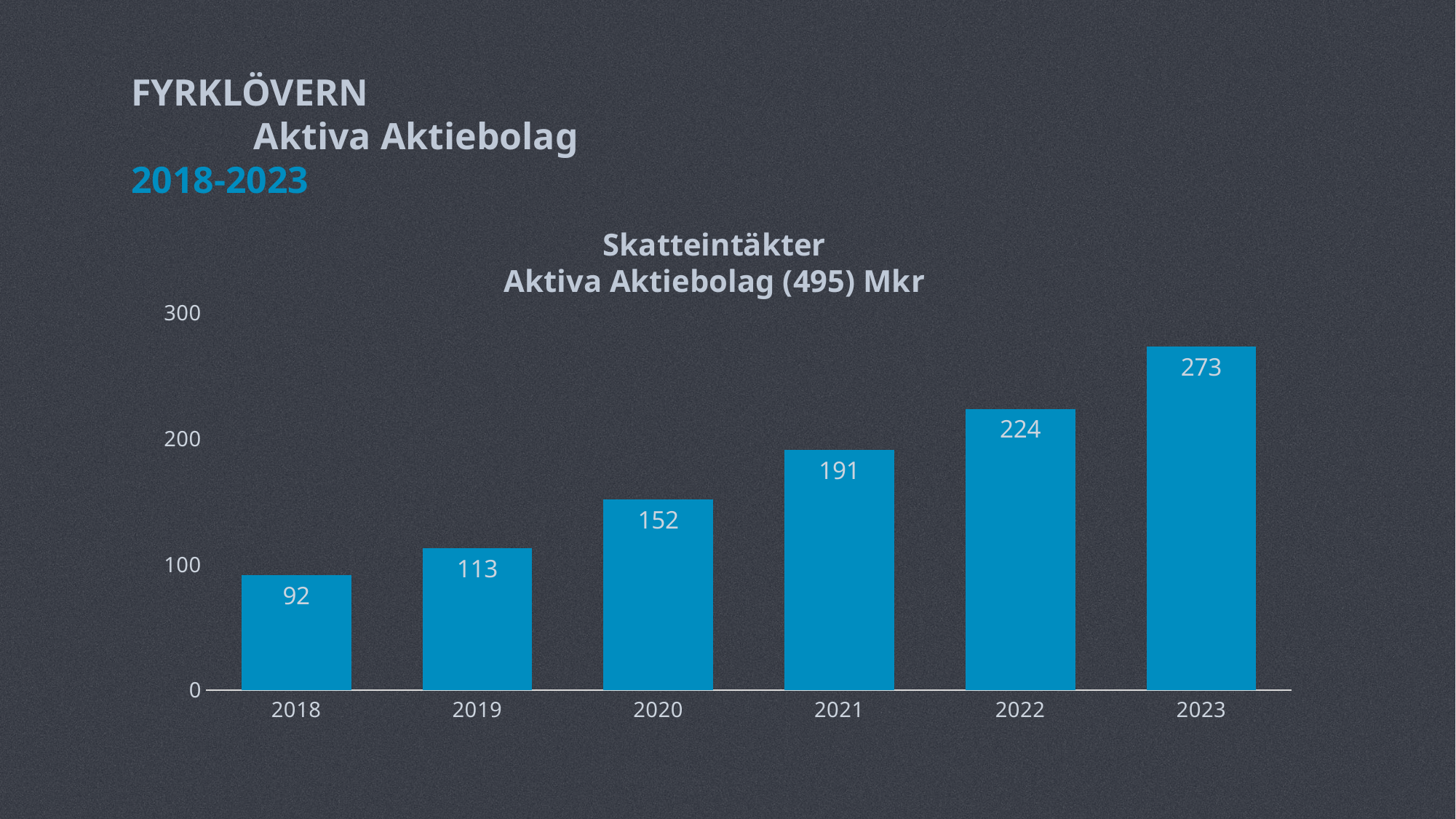
Which year has the highest value? 2023 Is the value for 2022 greater or less than 200? greater How many years are shown on the x axis? 6 What kind of chart is shown? bar chart What is the value for 2018? 92 Do the values rise or fall from 2018 to 2023? rise What is the value for 2023? 273 What is the difference between the values for 2020 and 2019? 39 Which year has the lowest value? 2018 What is the difference between the values for 2023 and 2022? 49 What is the value for 2021? 191 Which is larger, the value for 2020 or the value for 2021? 2021